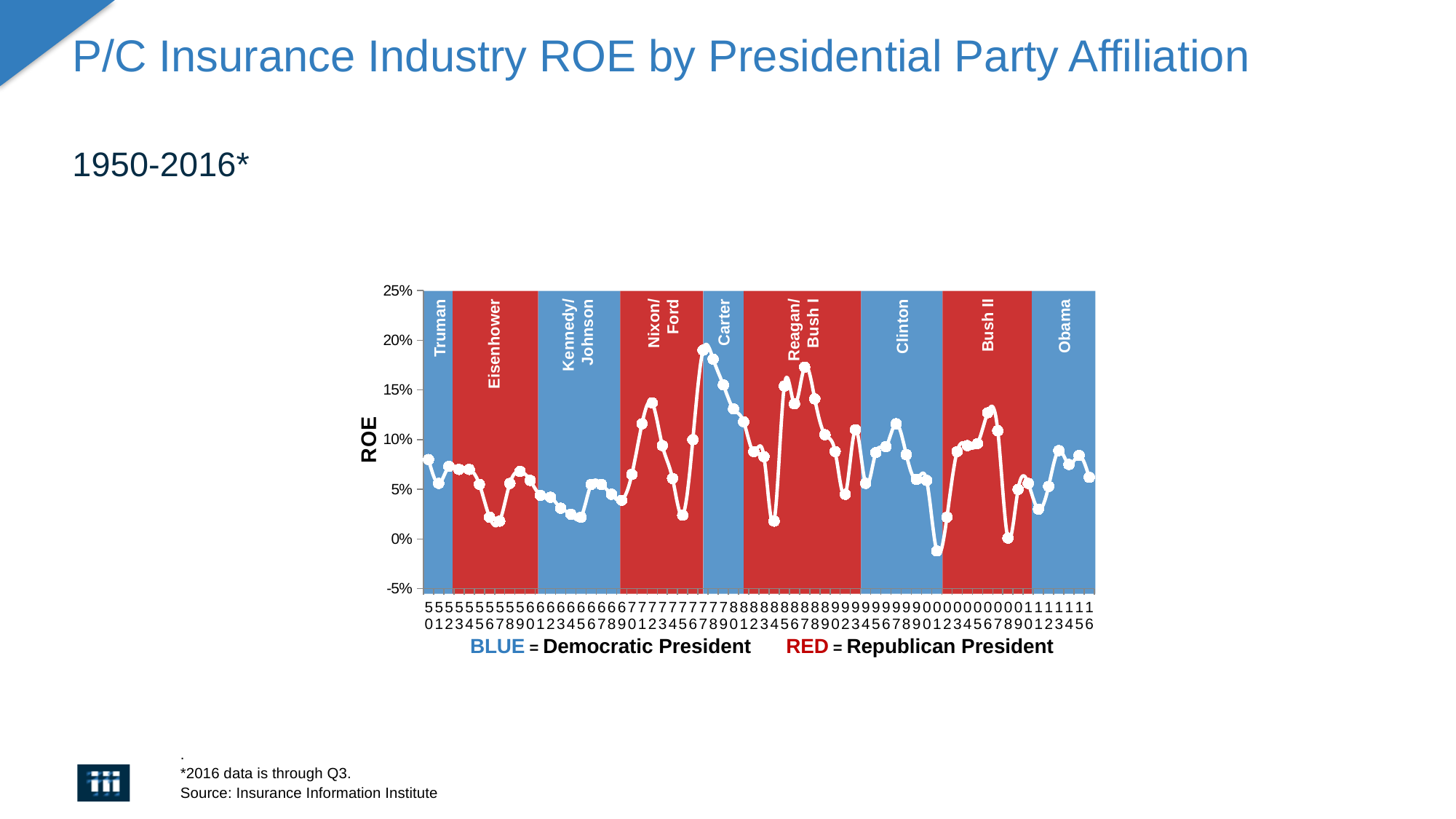
Is the ROE value for 1987 greater or less than 15%? greater In which year does the ROE line reach its highest point? 1977 Is the ROE value for 2001 greater or less than 0%? less Does the ROE line rise or fall from 1975 to 1977? rise How many presidential bands are labeled across the chart? 9 What kind of chart is shown on the slide? line chart Which is larger, the ROE value for 1977 or the ROE value for 1975? 1977 Is the ROE value for 1950 greater or less than 5%? greater Which color band represents a Democratic President? BLUE What is the label on the vertical axis of the chart? ROE